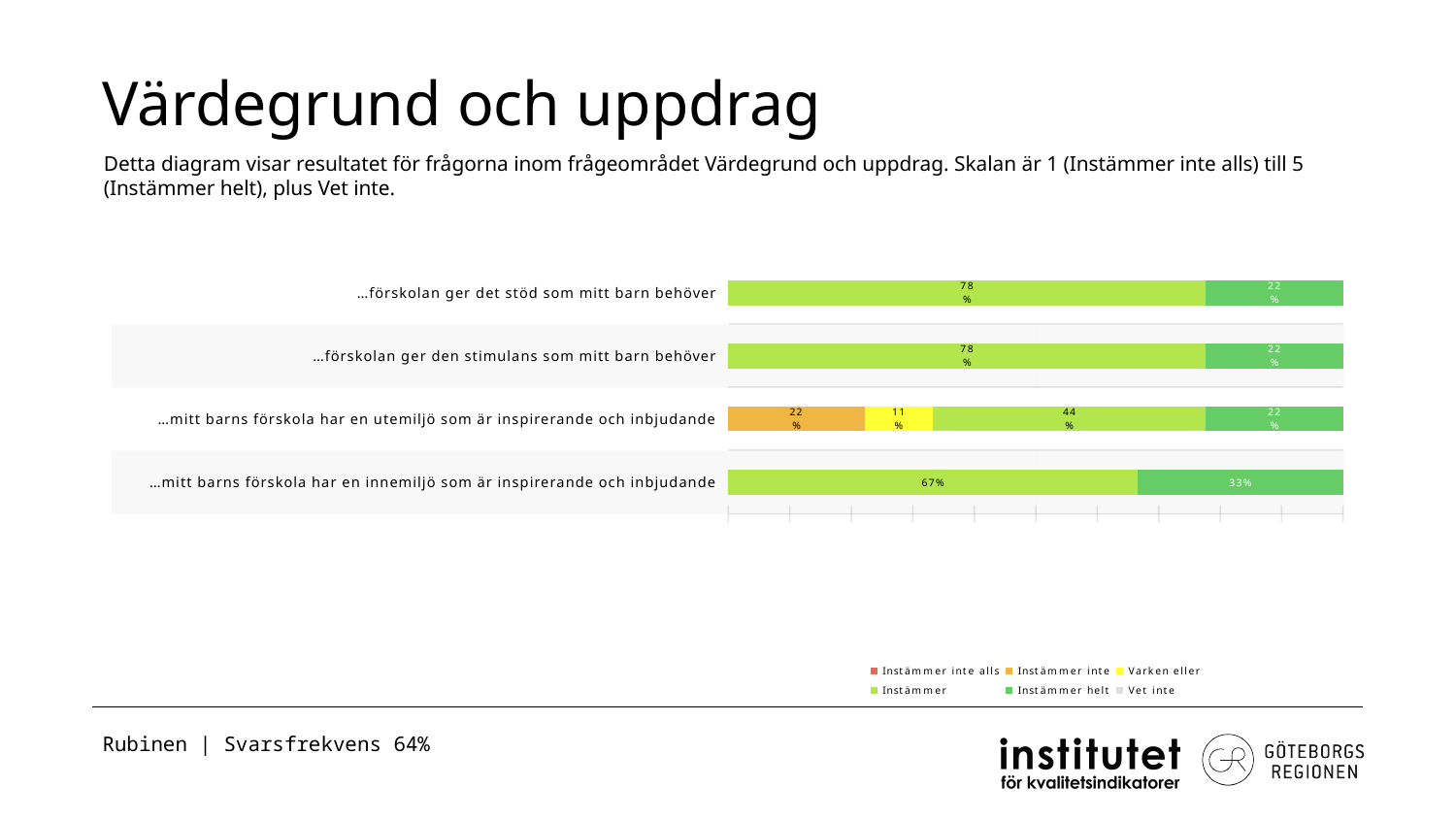
What is the 'Varken eller' value for '…mitt barns förskola har en utemiljö som är inspirerande och inbjudande'? 11% What type of chart is shown on the slide? Stacked bar chart What is the 'Instämmer inte' value for '…mitt barns förskola har en utemiljö som är inspirerande och inbjudande'? 22% Which statement has the highest 'Instämmer helt' share? …mitt barns förskola har en innemiljö som är inspirerande och inbjudande What is the difference between the 'Instämmer' value for '…förskolan ger den stimulans som mitt barn behöver' and the 'Instämmer' value for '…mitt barns förskola har en innemiljö som är inspirerande och inbjudande'? 11 percentage points How many series does the legend list? 6 How many categories (statements) are plotted in the chart? 4 Which is larger: the 'Instämmer' value for '…mitt barns förskola har en utemiljö som är inspirerande och inbjudande' or its 'Instämmer inte' value? Instämmer (44%) Which legend entry is shown in orange? Instämmer inte What is the 'Instämmer helt' value for '…mitt barns förskola har en innemiljö som är inspirerande och inbjudande'? 33% What is the 'Instämmer' value for '…förskolan ger det stöd som mitt barn behöver'? 78% Which statement has the lowest 'Instämmer' share? …mitt barns förskola har en utemiljö som är inspirerande och inbjudande